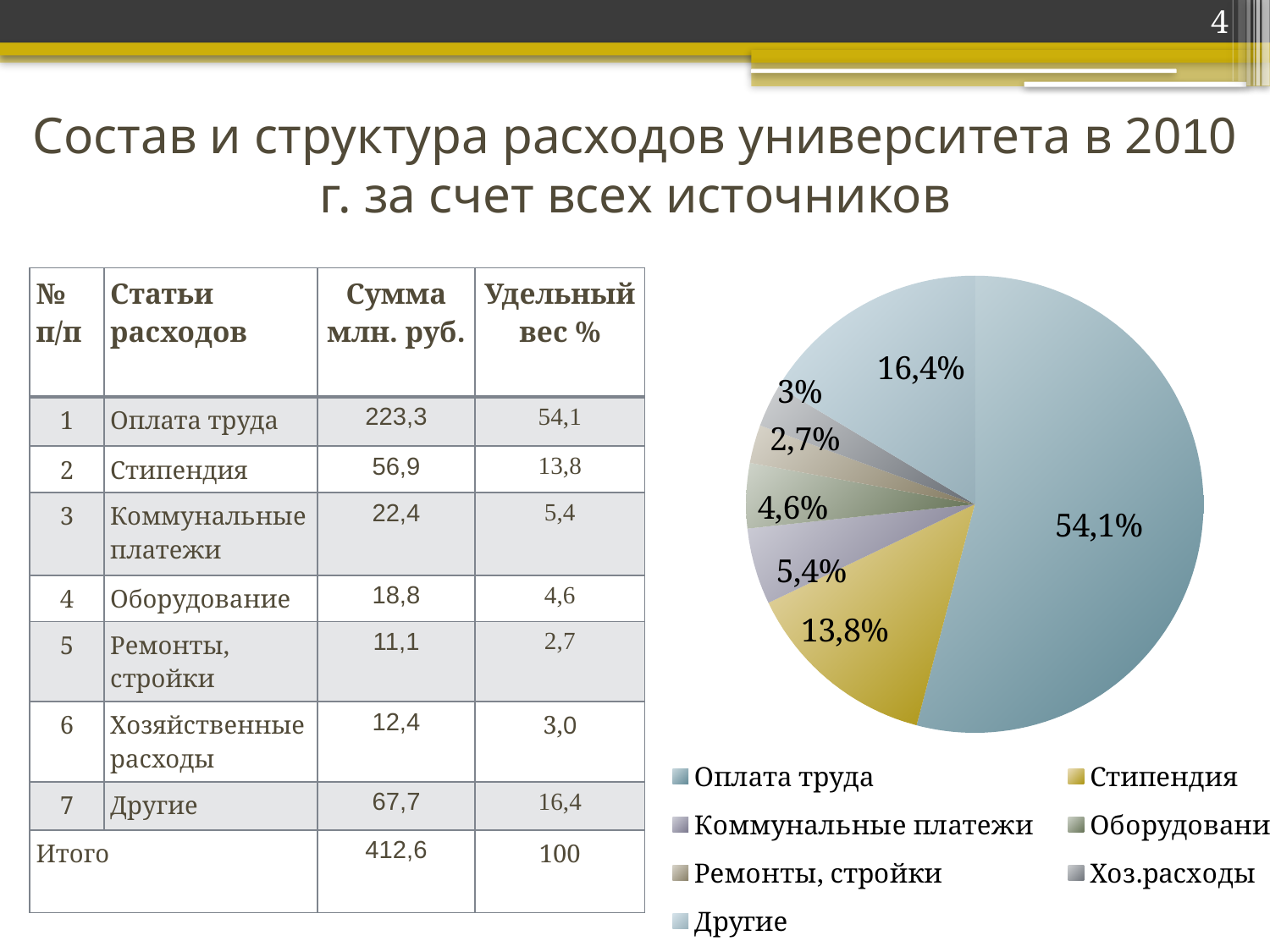
What share of the pie does Ремонты, стройки take? 2,7% What share of the pie does Оплата труда take? 54,1% How many entries does the legend of the pie chart list? 7 What share of the pie does Другие take? 16,4% Which slice is larger: Стипендия or Другие? Другие Which category has the largest slice of the pie? Оплата труда What is the difference in percentage points between the Оплата труда slice and the Другие slice? 37,7 Which category has the smallest slice of the pie? Ремонты, стройки What kind of chart is shown on the slide? pie chart How many slices does the pie chart have? 7